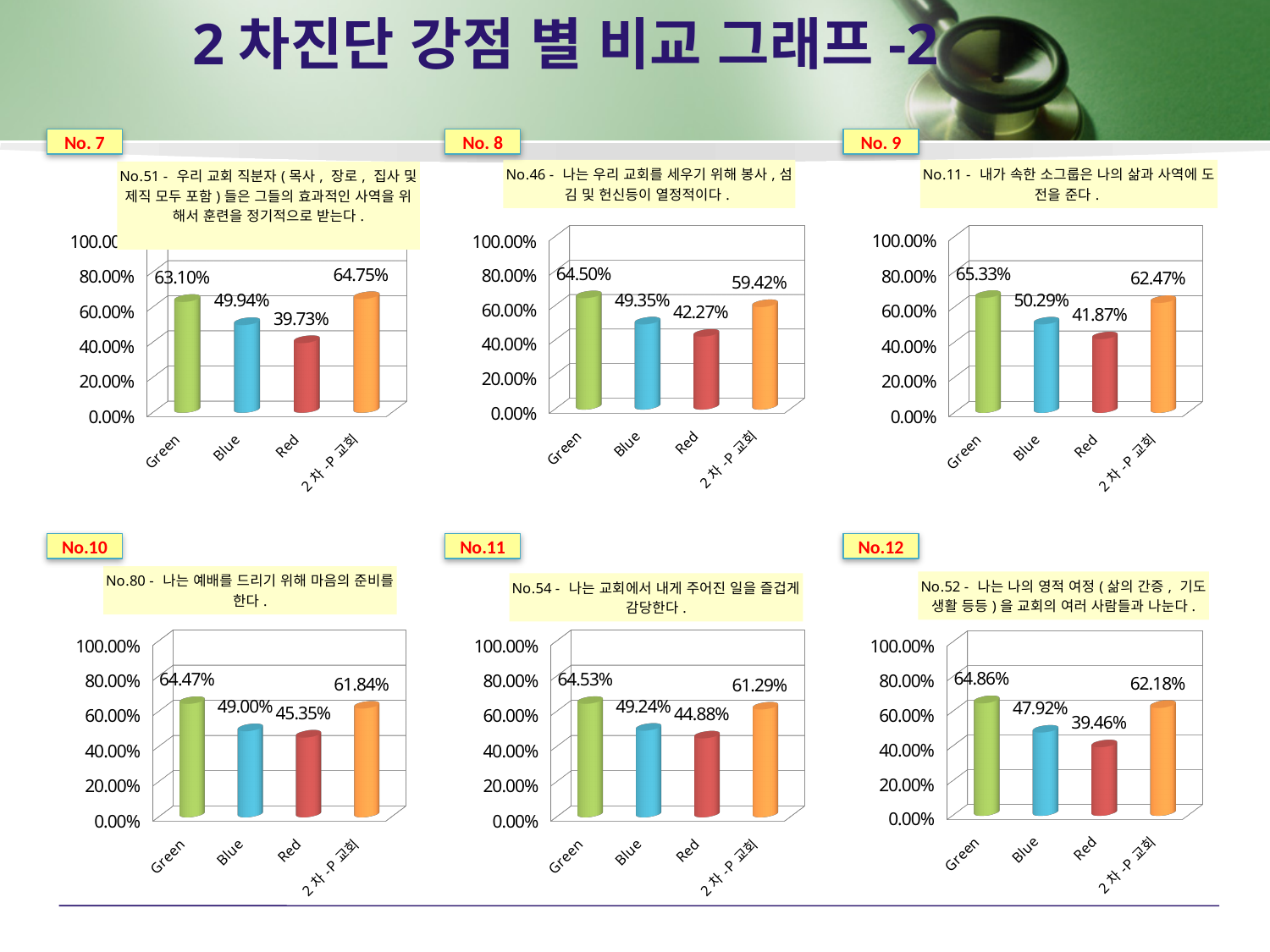
In the No.10 chart, is the value for Red greater or less than 60.00%? less In the No. 7 chart, what is the value for Green? 63.10% In the No. 7 chart, which is larger, the value for Blue or the value for Red? Blue In the No. 9 chart, what is the value for 2차-P 교회? 62.47% In the No.11 chart, which category has the lowest value? Red In the No.12 chart, what is the difference between the Green value and the Blue value? 16.94% In the No. 8 chart, what is the value for Red? 42.27% In the No.12 chart, which category has the highest value? Green In the No. 8 chart, what is the difference between the Green value and the Red value? 22.23% In the No.10 chart, what is the value for Blue? 49.00% How many categories are shown on the x axis of the No. 9 chart? 4 What kind of chart is the No.11 chart? Bar chart